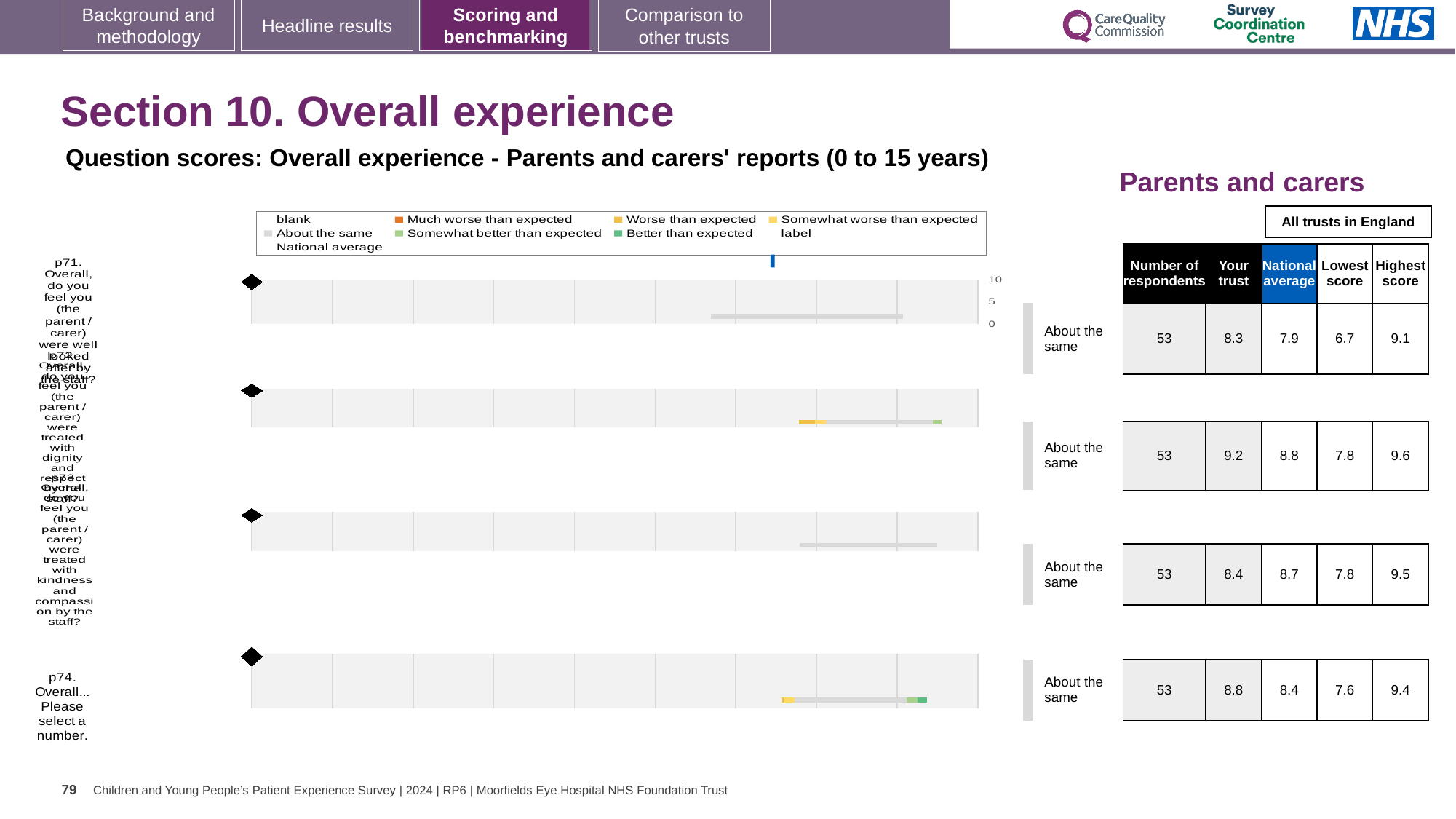
What kind of chart is shown on the slide? Bar chart How many respondents answered p72? 53 For p73 (treated with kindness and compassion), which is larger: the 'Your trust' score or the national average? National average What is the highest score across all trusts in England for p72 (treated with dignity and respect)? 9.6 Which question has the highest 'Your trust' score? p72 What is the lowest score across all trusts in England for p74? 7.6 How many questions are plotted on the chart? 4 What is the 'Your trust' score for p74 (Overall... Please select a number)? 8.8 What benchmark category is shown for p73? About the same What is the national average score for p71 (were well looked after by the staff)? 7.9 What is the difference between the 'Your trust' score and the national average for p71? 0.4 Which question has the lowest 'Your trust' score? p71